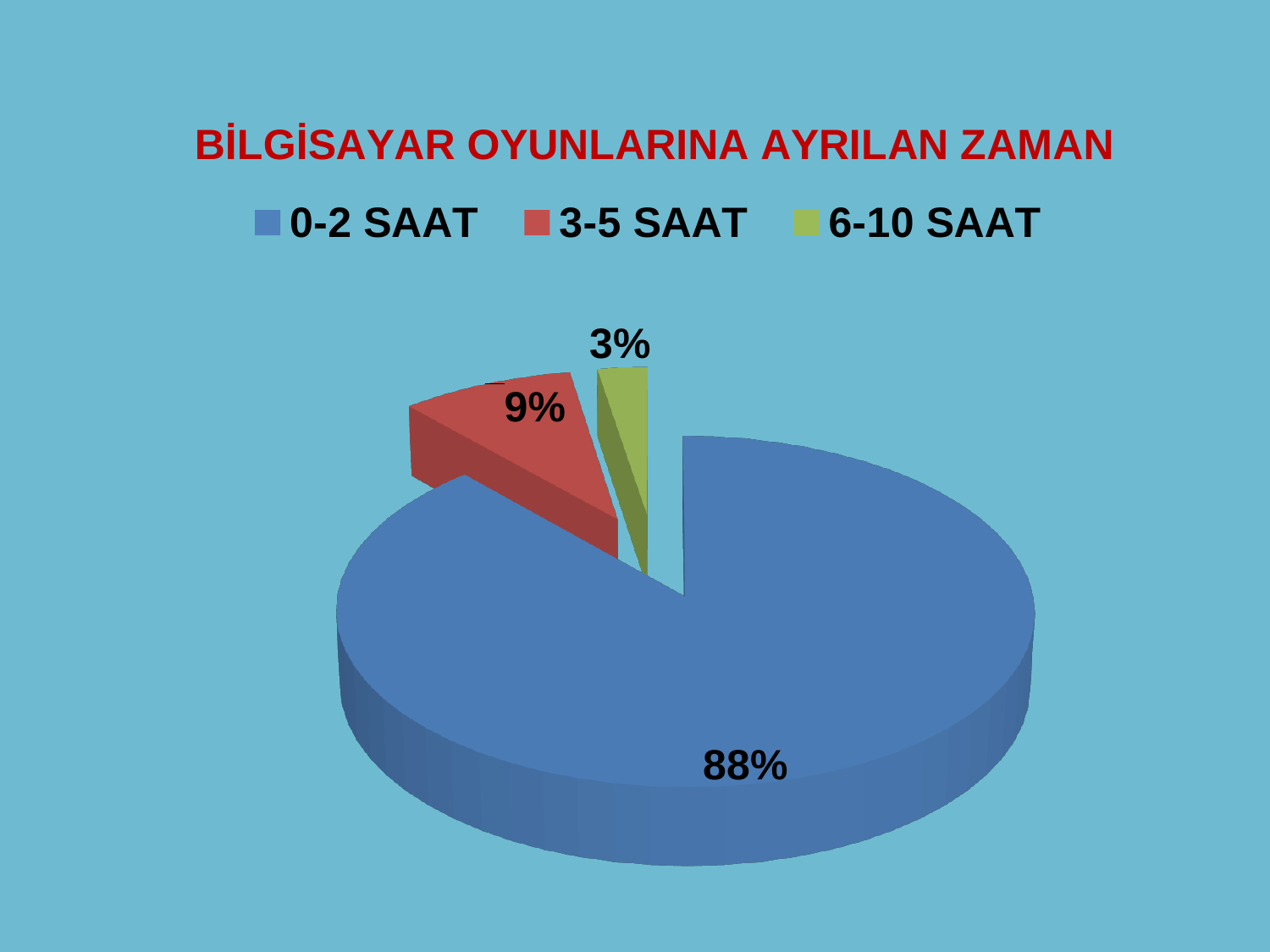
What is the difference in percentage points between the 0-2 SAAT slice and the 3-5 SAAT slice? 79 What is the difference in percentage points between the 3-5 SAAT slice and the 6-10 SAAT slice? 6 What share of the pie does the 0-2 SAAT slice represent? 88% What share of the pie does the 3-5 SAAT slice represent? 9% Which category has the smallest slice of the pie? 6-10 SAAT What is the title of the chart? BİLGİSAYAR OYUNLARINA AYRILAN ZAMAN What kind of chart is shown on the slide? Pie chart Which category has the largest slice of the pie? 0-2 SAAT What colour is the 3-5 SAAT slice? Red What share of the pie does the 6-10 SAAT slice represent? 3% Which slice is larger, 3-5 SAAT or 6-10 SAAT? 3-5 SAAT How many categories does the pie chart show? 3